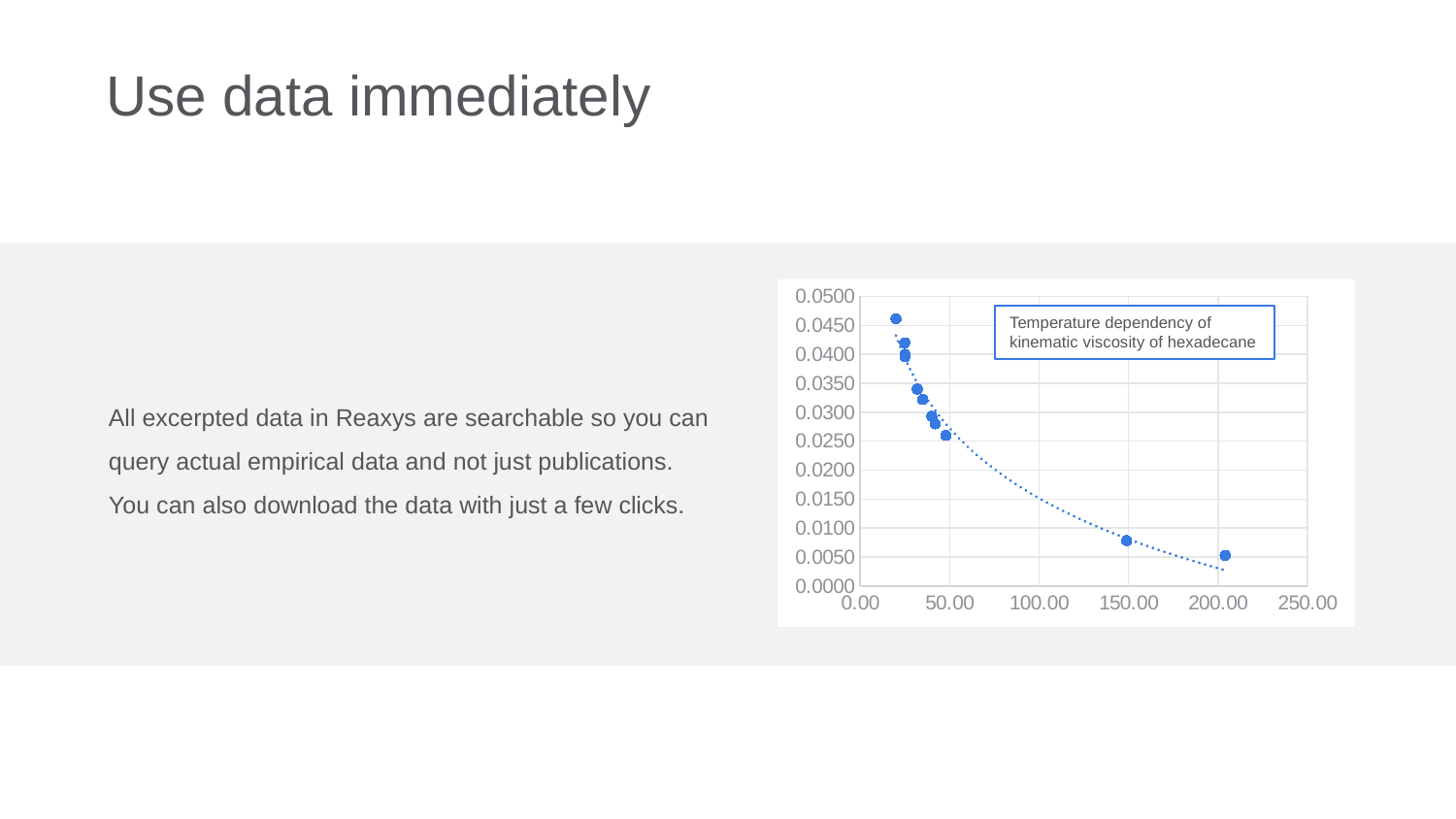
Is the value of the point near x = 50 greater or less than 0.0300? less What kind of chart is shown on the slide? scatter chart Do the plotted values rise or fall as the x-axis value increases? fall What is the title shown in the box inside the chart? Temperature dependency of kinematic viscosity of hexadecane Is the value of the point near x = 150 greater or less than 0.0100? less Is the value of the point near x = 30 greater or less than 0.0300? greater What is the maximum value shown on the y-axis? 0.0500 Which has the larger y value: the point near x = 150 or the point near x = 200? the point near x = 150